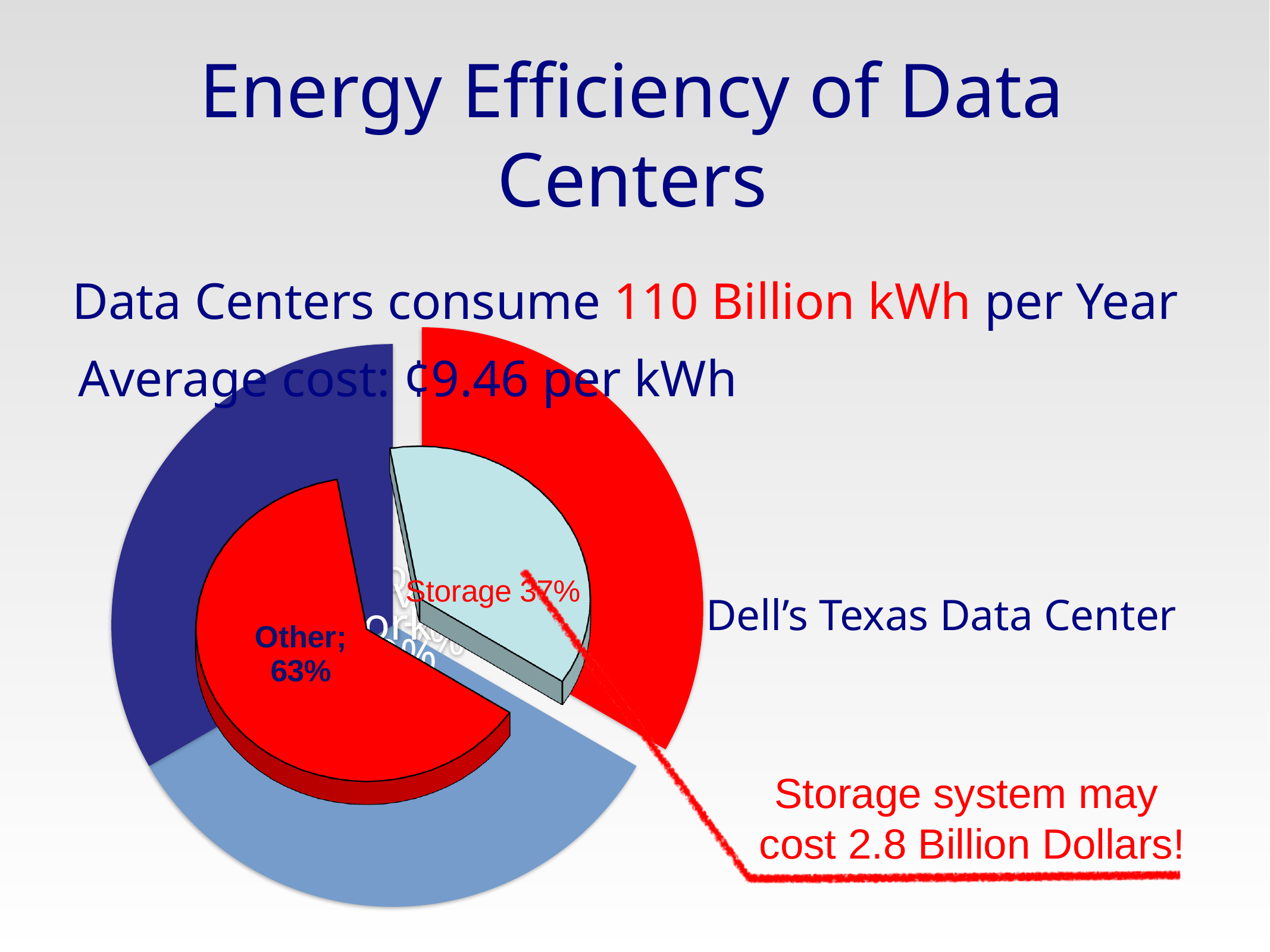
What colour is the Storage slice of the pie chart? light blue Which is larger in the pie chart, the Other slice or the Storage slice? Other What share of the pie chart is labelled Other? 63% Is the Storage slice of the pie chart greater or less than 50%? less What is the difference in percentage points between the Other slice and the Storage slice? 26 Which slice of the pie chart is the smallest? Storage What share of the pie chart is labelled Storage? 37% What colour is the Other slice of the pie chart? red What kind of chart is shown on the slide? pie chart Which slice of the pie chart is the largest? Other